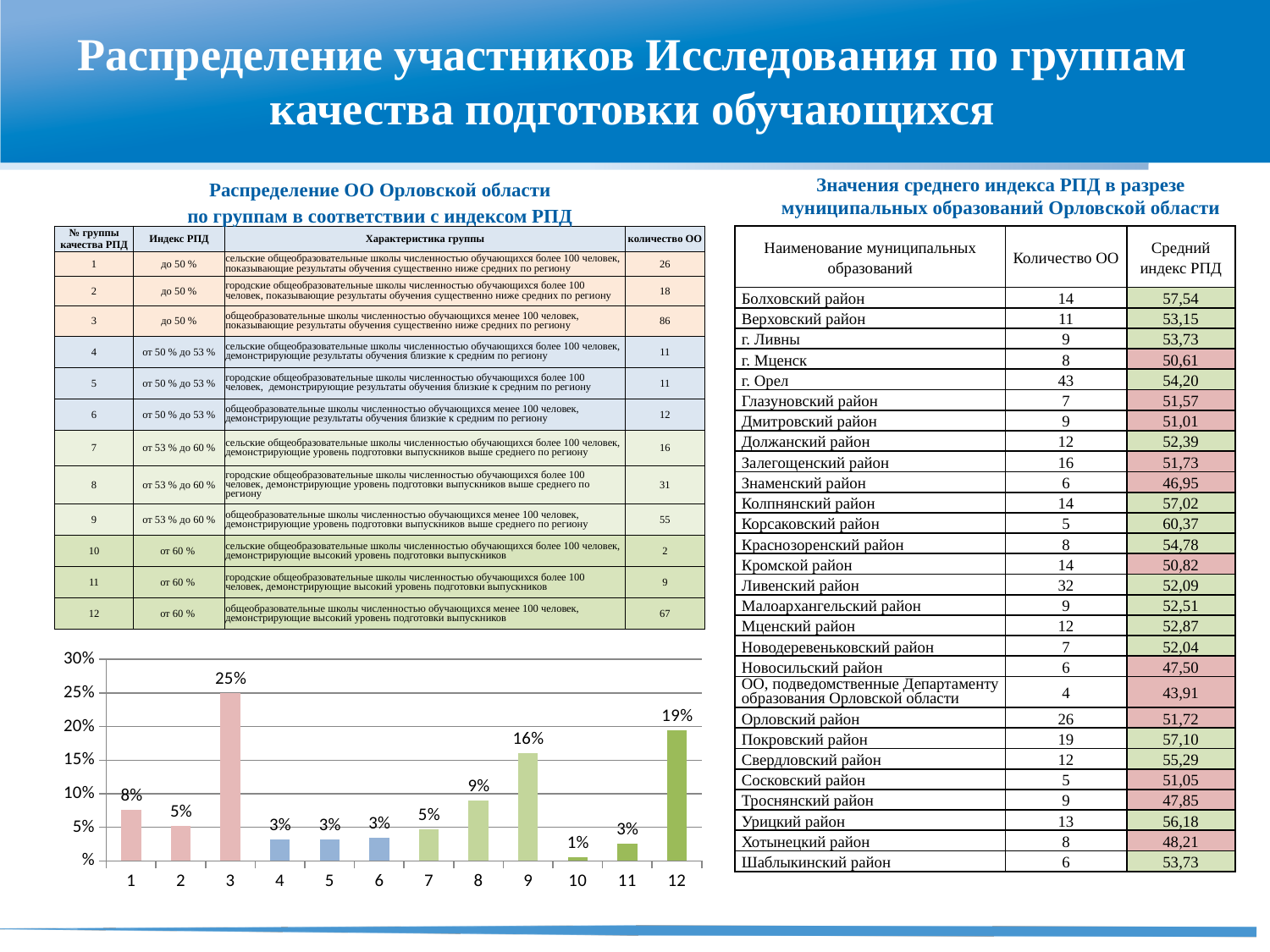
Which category has the lowest value in the bar chart? 10 Which has a larger value in the bar chart, category 1 or category 8? 8 What is the value shown for category 9 in the bar chart? 16% What is the value shown for category 3 in the bar chart? 25% What is the difference between the values for category 3 and category 12 in the bar chart? 6% Which category has the highest value in the bar chart? 3 What is the difference between the values for category 9 and category 8 in the bar chart? 7% How many categories are shown on the x axis of the bar chart? 12 What type of chart is shown at the bottom left of the slide? bar chart What is the value shown for category 12 in the bar chart? 19% What is the value shown for category 1 in the bar chart? 8% What is the highest value marked on the y axis of the bar chart? 30%